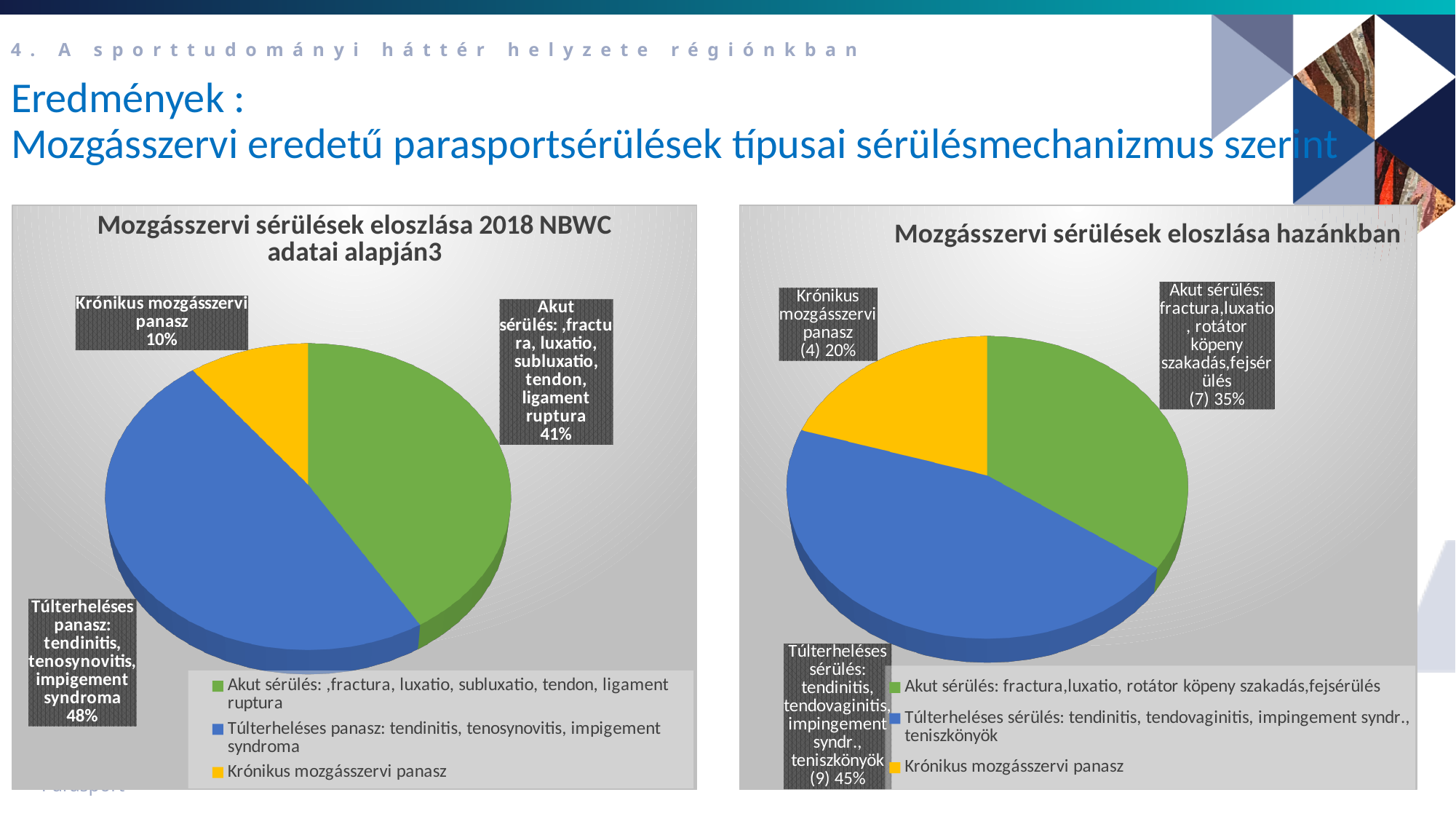
In the right chart (Mozgásszervi sérülések eloszlása hazánkban), what share does Akut sérülés have? 35% In the right chart (Mozgásszervi sérülések eloszlása hazánkban), what share does Krónikus mozgásszervi panasz have? 20% In the left chart (Mozgásszervi sérülések eloszlása 2018 NBWC adatai alapján3), which category has the smallest slice? Krónikus mozgásszervi panasz What type of chart is the left chart (Mozgásszervi sérülések eloszlása 2018 NBWC adatai alapján3)? Pie chart In the left chart (Mozgásszervi sérülések eloszlása 2018 NBWC adatai alapján3), what share does Krónikus mozgásszervi panasz have? 10% In the right chart (Mozgásszervi sérülések eloszlása hazánkban), what colour is the Krónikus mozgásszervi panasz slice? Yellow In the left chart (Mozgásszervi sérülések eloszlása 2018 NBWC adatai alapján3), which category has the largest slice? Túlterheléses panasz In the right chart (Mozgásszervi sérülések eloszlása hazánkban), which category has the largest slice? Túlterheléses sérülés In the left chart (Mozgásszervi sérülések eloszlása 2018 NBWC adatai alapján3), what is the difference in percentage points between Túlterheléses panasz and Akut sérülés? 7 In the right chart (Mozgásszervi sérülések eloszlása hazánkban), how many cases are labelled for Túlterheléses sérülés? 9 In the right chart (Mozgásszervi sérülések eloszlása hazánkban), how many categories does the legend list? 3